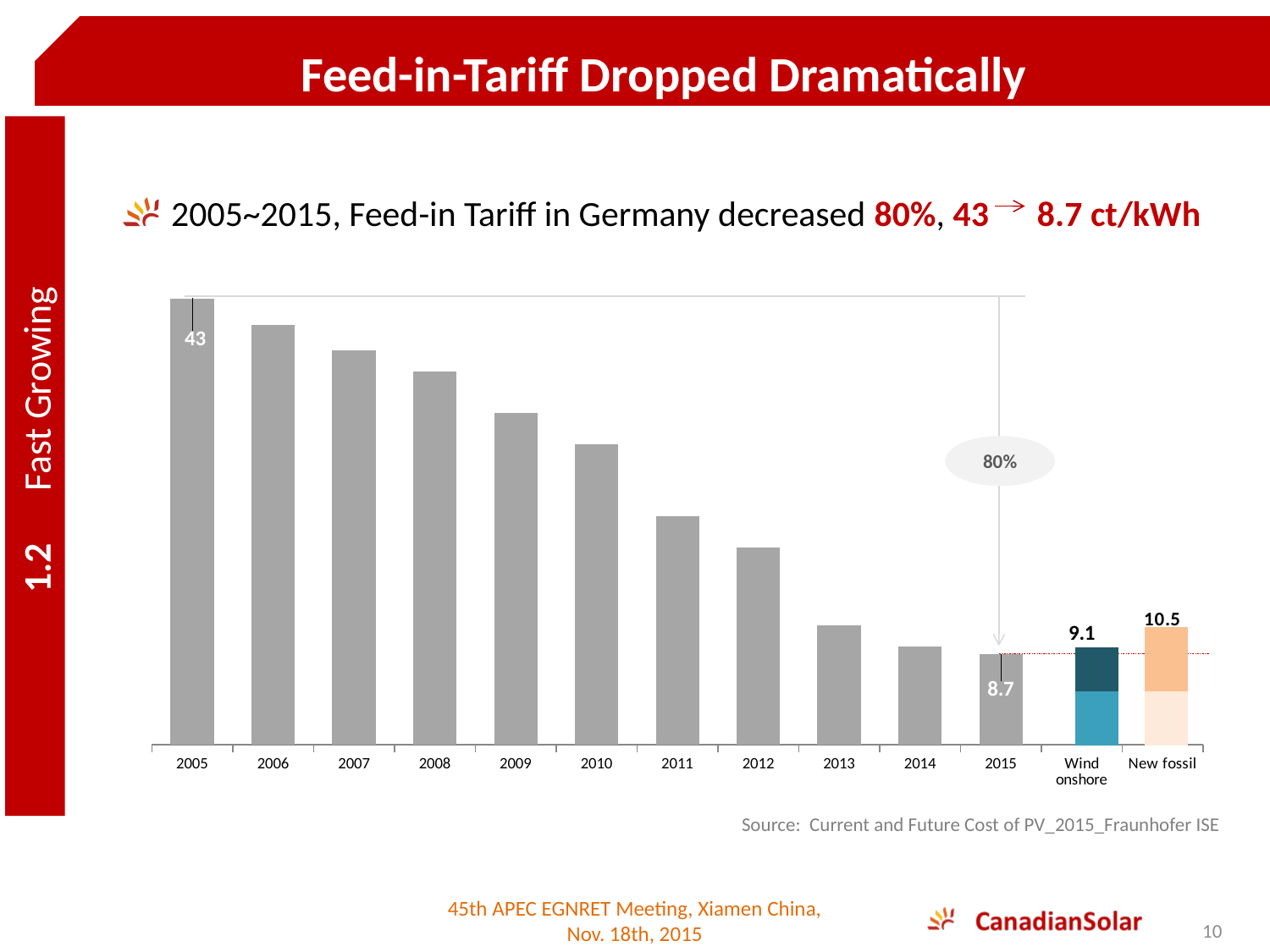
What is the feed-in tariff value shown for 2005? 43 What value is labelled on the New fossil bar? 10.5 Which year has the highest bar in the chart? 2005 What is the feed-in tariff value shown for 2015? 8.7 What kind of chart is shown on the slide? Bar chart What percentage decrease is labelled in the oval on the chart? 80% What value is labelled on the Wind onshore bar? 9.1 Do the values rise or fall from 2005 to 2015? Fall Which is larger, the Wind onshore value or the New fossil value? New fossil How many categories are shown along the x axis? 13 What is the difference between the 2005 value and the 2015 value? 34.3 Which category has the lowest bar in the chart? 2015